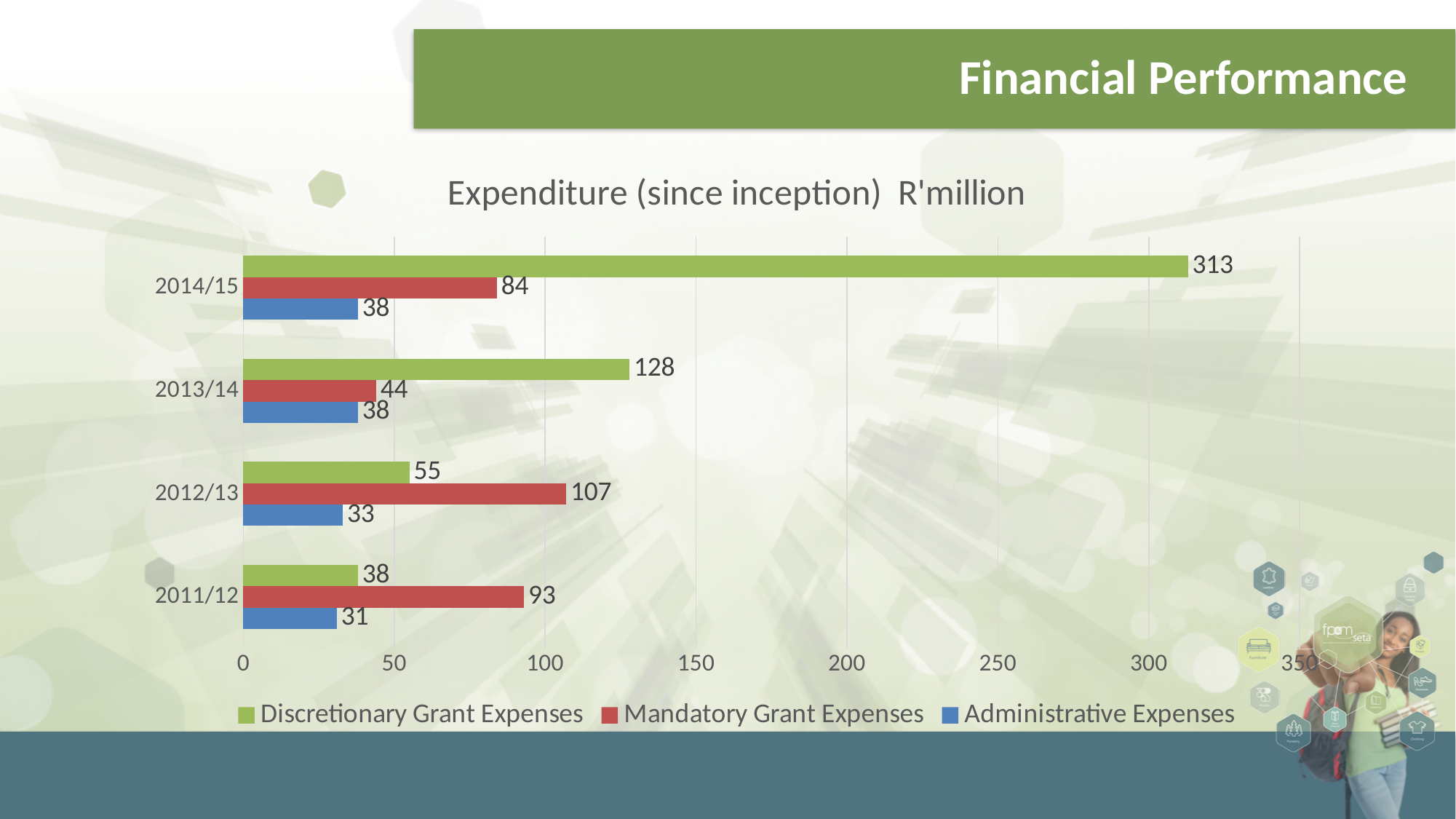
What is the title of the chart? Expenditure (since inception) R'million What is the difference between Discretionary Grant Expenses in 2014/15 and 2013/14? 185 What is the value of Discretionary Grant Expenses for 2014/15? 313 How many series does the legend list? 3 What is the value of Mandatory Grant Expenses for 2012/13? 107 Which year has the lowest Mandatory Grant Expenses? 2013/14 Is the value of Discretionary Grant Expenses for 2014/15 greater or less than 300? greater What is the value of Administrative Expenses for 2011/12? 31 Which is larger in 2012/13: Discretionary Grant Expenses or Mandatory Grant Expenses? Mandatory Grant Expenses Which year has the highest Discretionary Grant Expenses? 2014/15 How many years (categories) are shown on the chart? 4 What kind of chart is shown on the slide? bar chart